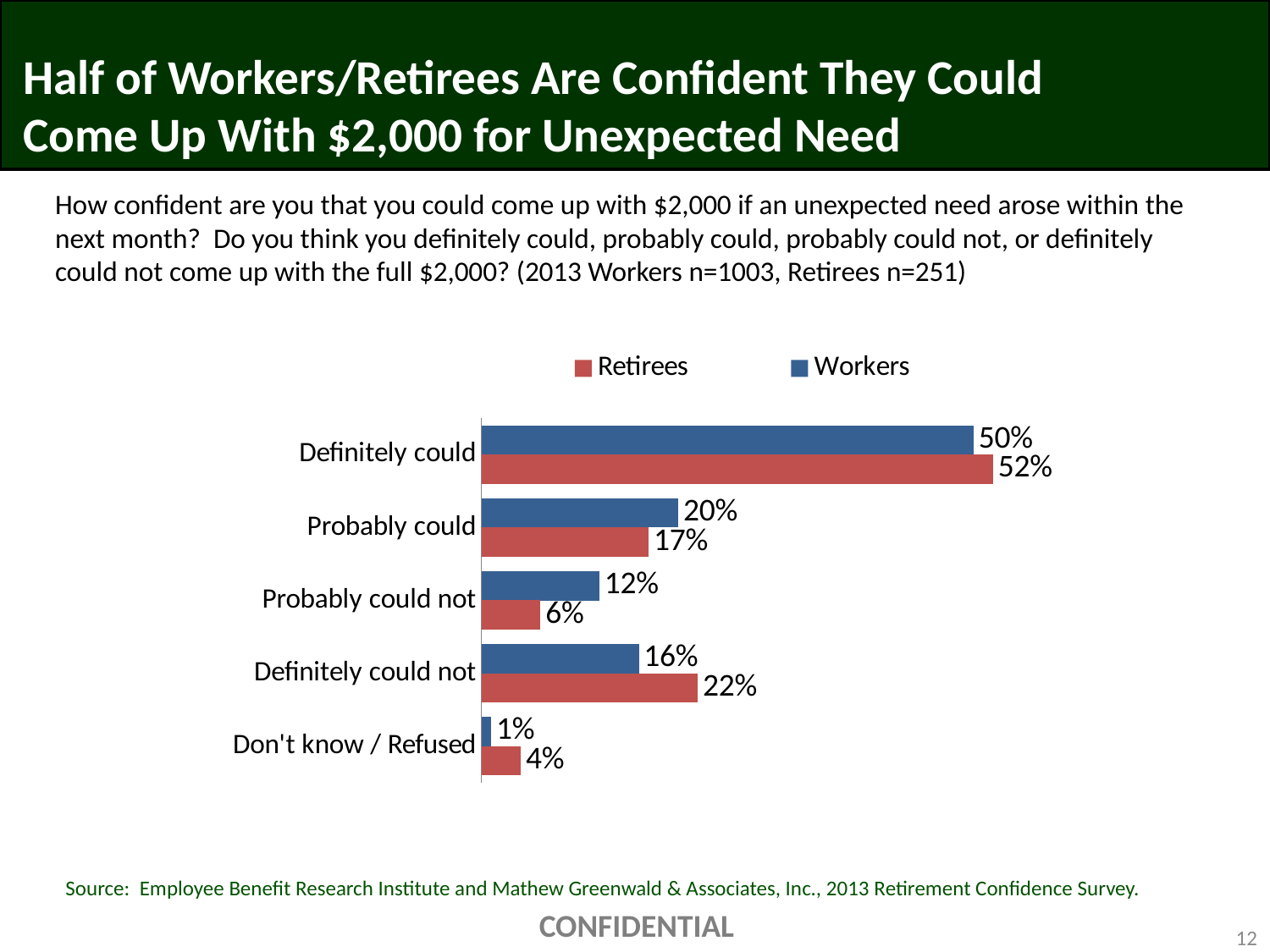
What is the value for Retirees in the 'Probably could not' category? 6% What percentage of Retirees said they definitely could not come up with $2,000? 22% What kind of chart is shown on the slide? Bar chart What percentage of Workers said they definitely could come up with $2,000? 50% How many response categories are shown on the chart? 5 What is the difference between the Retirees and Workers values for 'Definitely could not'? 6% What is the difference between the Workers and Retirees values for 'Probably could not'? 6% How many series does the legend list? 2 What colour represents Retirees in the chart? Red Which category has the highest value for Retirees? Definitely could Which is larger for 'Probably could': the Workers value or the Retirees value? Workers Which category has the lowest value for Workers? Don't know / Refused